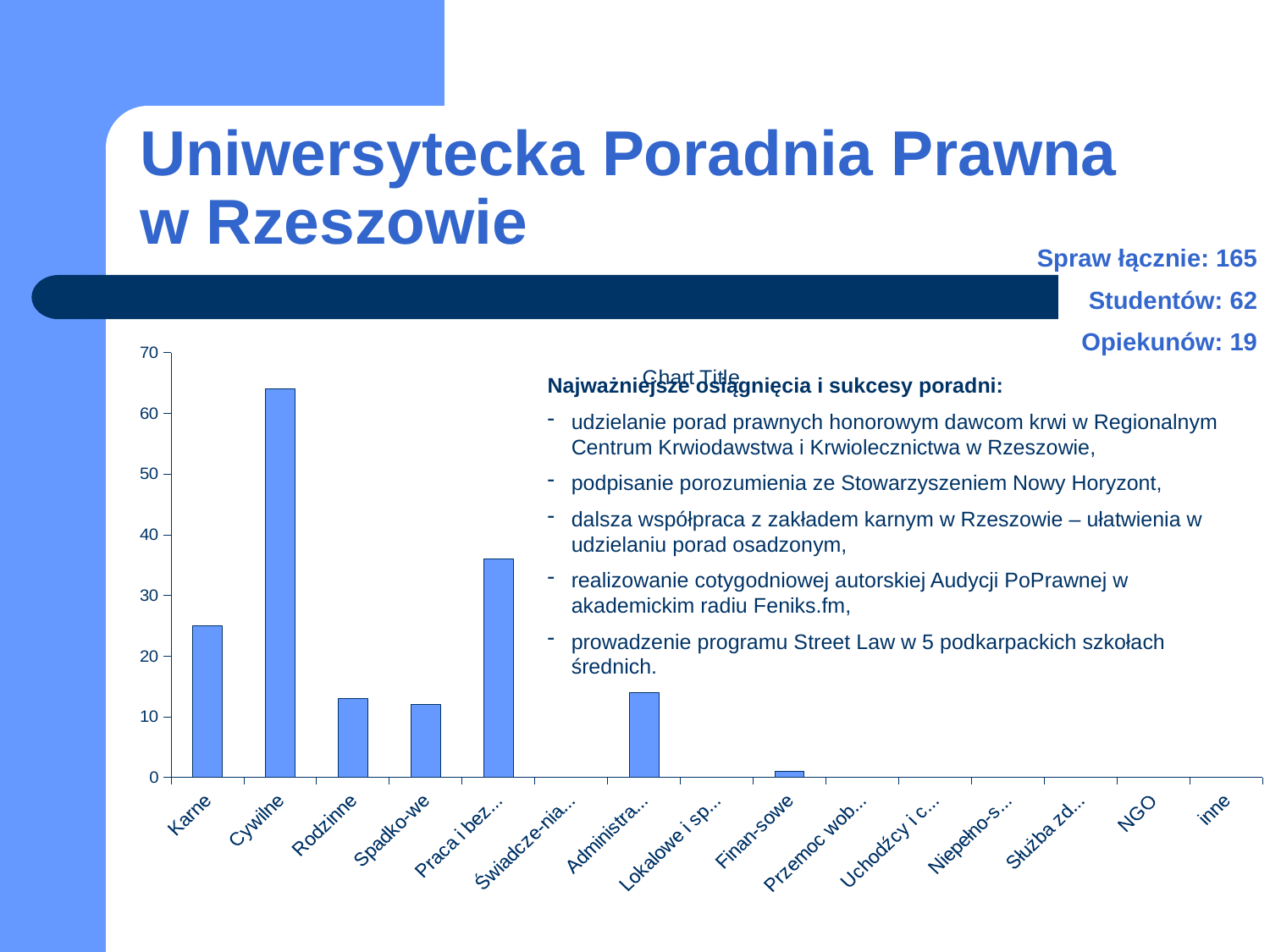
Is the value for Finan-sowe greater or less than 10? less Is the value for Praca i bez... greater or less than 30? greater Is the value for Praca i bez... greater or less than 40? less Which is larger, the value for Karne or the value for Administra...? Karne Which category has the highest value in the chart? Cywilne What is the title shown on the chart? Chart Title How many categories are shown on the x axis of the chart? 15 Which is larger, the value for Karne or the value for Praca i bez...? Praca i bez... What kind of chart is shown on the slide? bar chart